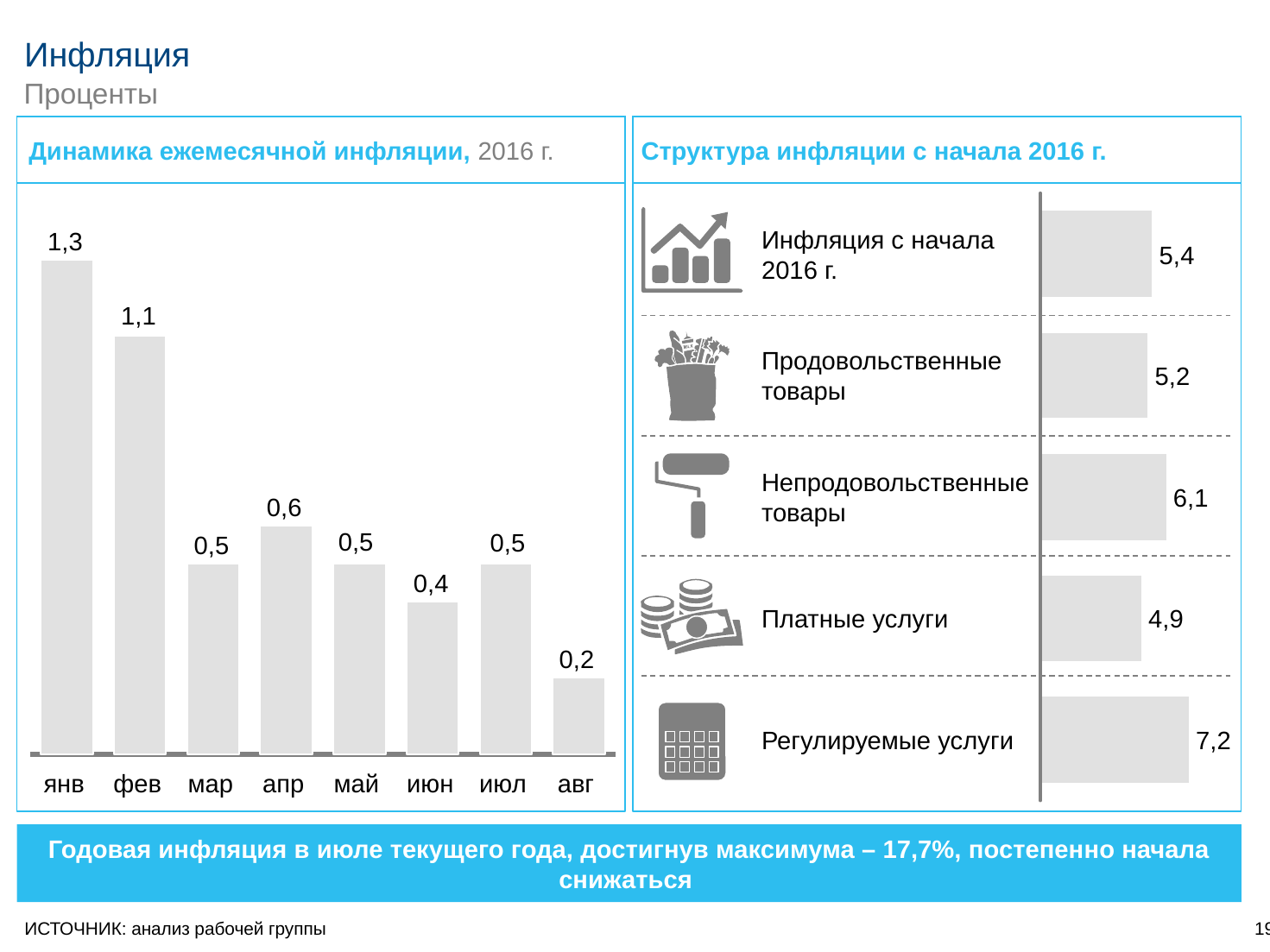
In the chart 'Динамика ежемесячной инфляции, 2016 г.', how many months are shown? 8 In the chart 'Структура инфляции с начала 2016 г.', which category has the highest value? Регулируемые услуги In the chart 'Динамика ежемесячной инфляции, 2016 г.', what is the difference between the values for янв and фев? 0,2 In the chart 'Структура инфляции с начала 2016 г.', what is the difference between Регулируемые услуги and Платные услуги? 2,3 In the chart 'Структура инфляции с начала 2016 г.', which is larger: Продовольственные товары or Непродовольственные товары? Непродовольственные товары In the chart 'Динамика ежемесячной инфляции, 2016 г.', what is the value for янв? 1,3 In the chart 'Структура инфляции с начала 2016 г.', what is the value for Платные услуги? 4,9 What kind of chart is 'Динамика ежемесячной инфляции, 2016 г.'? bar chart In the chart 'Динамика ежемесячной инфляции, 2016 г.', what is the value for авг? 0,2 In the chart 'Динамика ежемесячной инфляции, 2016 г.', which month has the lowest value? авг In the chart 'Динамика ежемесячной инфляции, 2016 г.', do the values generally rise or fall from янв to авг? fall In the chart 'Динамика ежемесячной инфляции, 2016 г.', which month has the highest value? янв